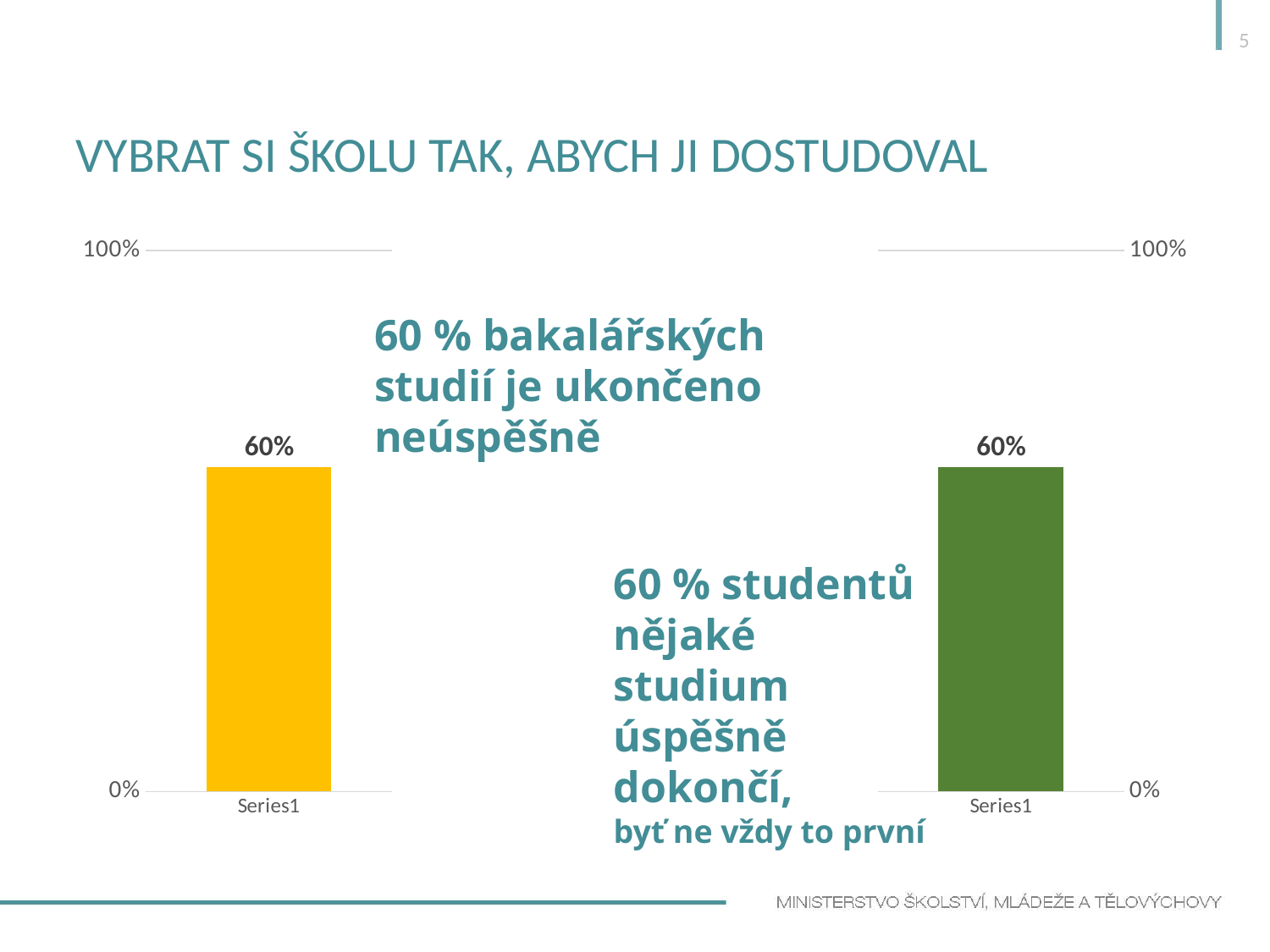
On the right chart, what is the value of the bar labelled Series1? 60% What kind of chart is the right chart? bar chart What kind of chart is the left chart? bar chart How many bars does the right chart show? 1 On the right chart, is the value for Series1 greater or less than 0%? greater How many charts are on the slide? 2 On the left chart, is the value for Series1 greater or less than 100%? less On the left chart, what is the value of the bar labelled Series1? 60% What is the difference between the Series1 value on the left chart and the Series1 value on the right chart? 0% What is the maximum value shown on the vertical axis of the left chart? 100% What colour is the bar on the right chart? green How many bars does the left chart show? 1